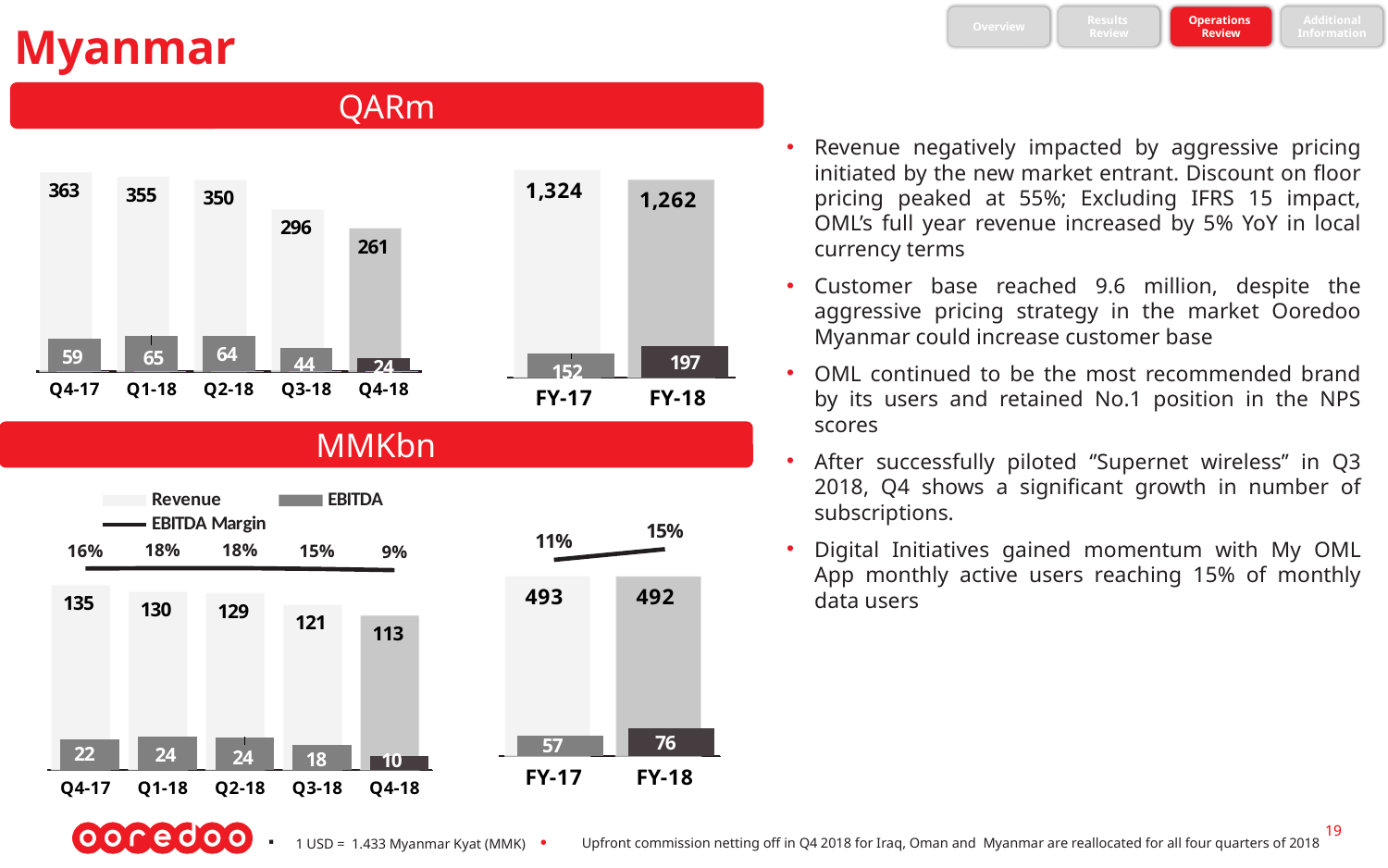
In the QARm full-year chart, what is the difference between FY-17 and FY-18 revenue? 62 In the QARm quarterly chart, which quarter has the lowest EBITDA? Q4-18 In the MMKbn full-year chart, what is the EBITDA margin for FY-18? 15% In the MMKbn quarterly chart, what is the EBITDA margin for Q2-18? 18% How many quarters are shown in the QARm quarterly chart? 5 In the MMKbn quarterly chart, how many series does the legend list? 3 In the QARm quarterly chart, which quarter has the highest revenue? Q4-17 In the MMKbn quarterly chart, how does revenue change from Q4-17 to Q4-18? It falls In the QARm full-year chart, what is the EBITDA value for FY-18? 197 In the QARm quarterly chart, what is the revenue value for Q4-18? 261 In the MMKbn full-year chart, which year has the larger EBITDA, FY-17 or FY-18? FY-18 In the QARm quarterly chart, what is the EBITDA value for Q1-18? 65